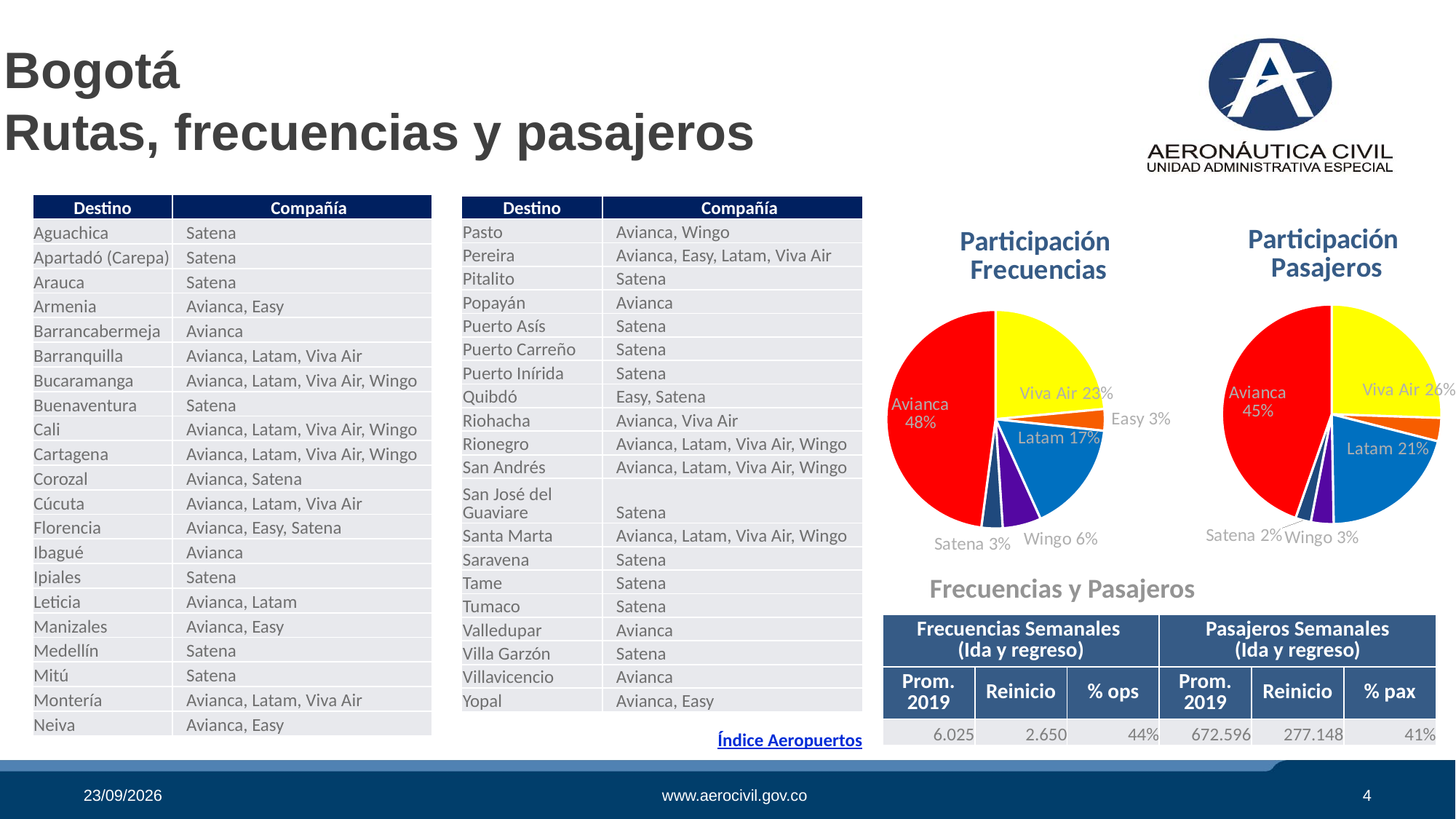
In the 'Participación Pasajeros' chart, which is larger, the share of Latam or the share of Viva Air? Viva Air In the 'Participación Pasajeros' chart, what share does Wingo have? 3% What colour is the Avianca slice in the 'Participación Pasajeros' chart? Red In the 'Participación Pasajeros' chart, which airline has the smallest labelled share? Satena What type of chart is 'Participación Frecuencias'? Pie chart In the 'Participación Frecuencias' chart, what share does Latam have? 17% How many slices are labelled in the 'Participación Frecuencias' chart? 6 In the 'Participación Frecuencias' chart, what share does Avianca have? 48% In the 'Participación Pasajeros' chart, what share does Viva Air have? 26% In the 'Participación Frecuencias' chart, which airline has the largest share? Avianca In the 'Participación Frecuencias' chart, what is the difference between the shares of Viva Air and Latam? 6 percentage points In the 'Participación Frecuencias' chart, which is larger, the share of Wingo or the share of Satena? Wingo